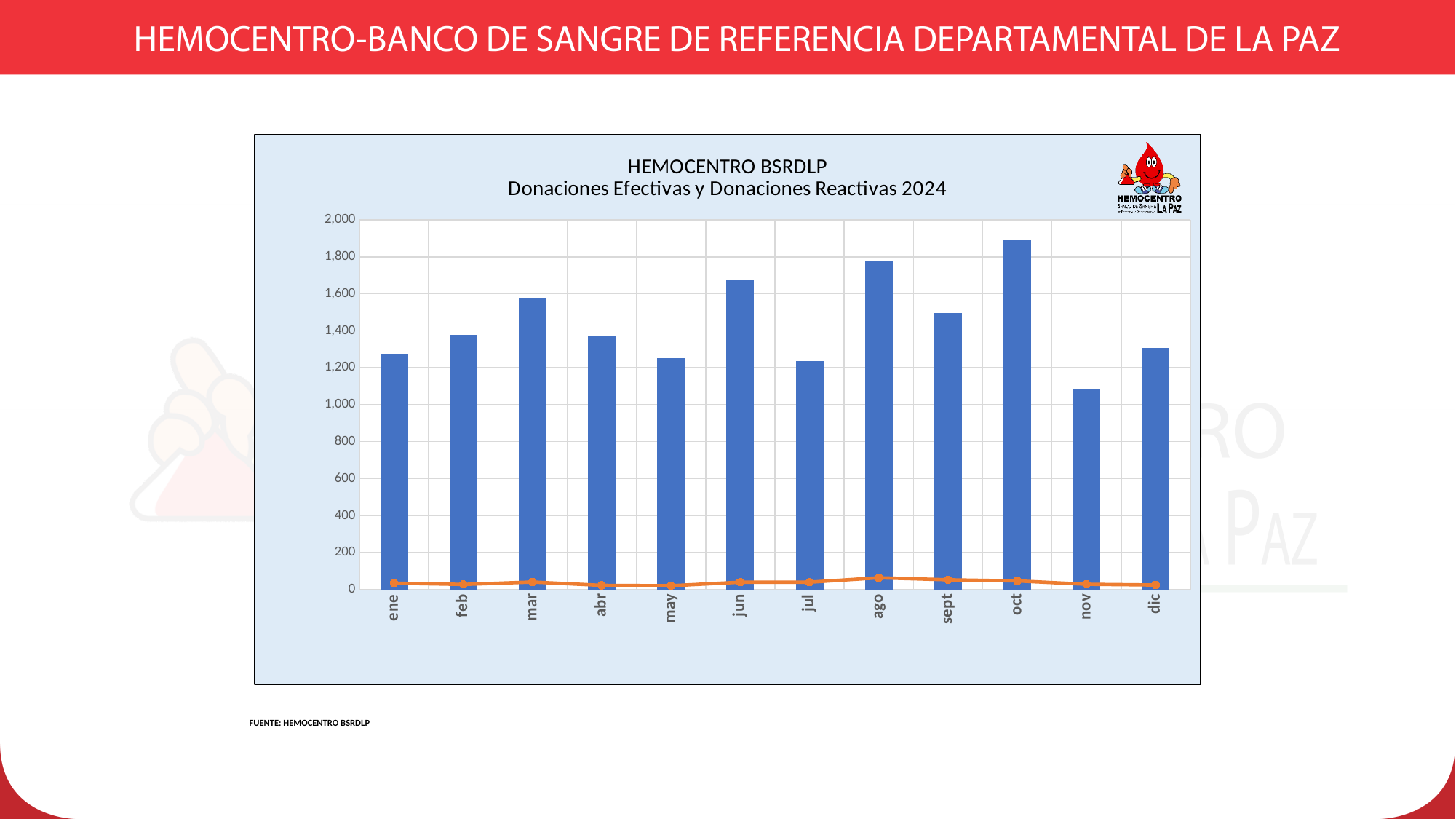
Is the bar value for oct greater or less than 1,800? greater What kind of chart is shown on the slide? bar chart with a line Which bar is taller, mar or feb? mar Which bar is taller, ago or sept? ago Which month has the shortest bar in the chart? nov What is the title of the chart? HEMOCENTRO BSRDLP Donaciones Efectivas y Donaciones Reactivas 2024 How many months are shown on the x axis of the chart? 12 Is the bar value for jun greater or less than 1,600? greater Which month has the tallest bar in the chart? oct Is the bar value for nov greater or less than 1,200? less Which bar is taller, nov or dic? dic